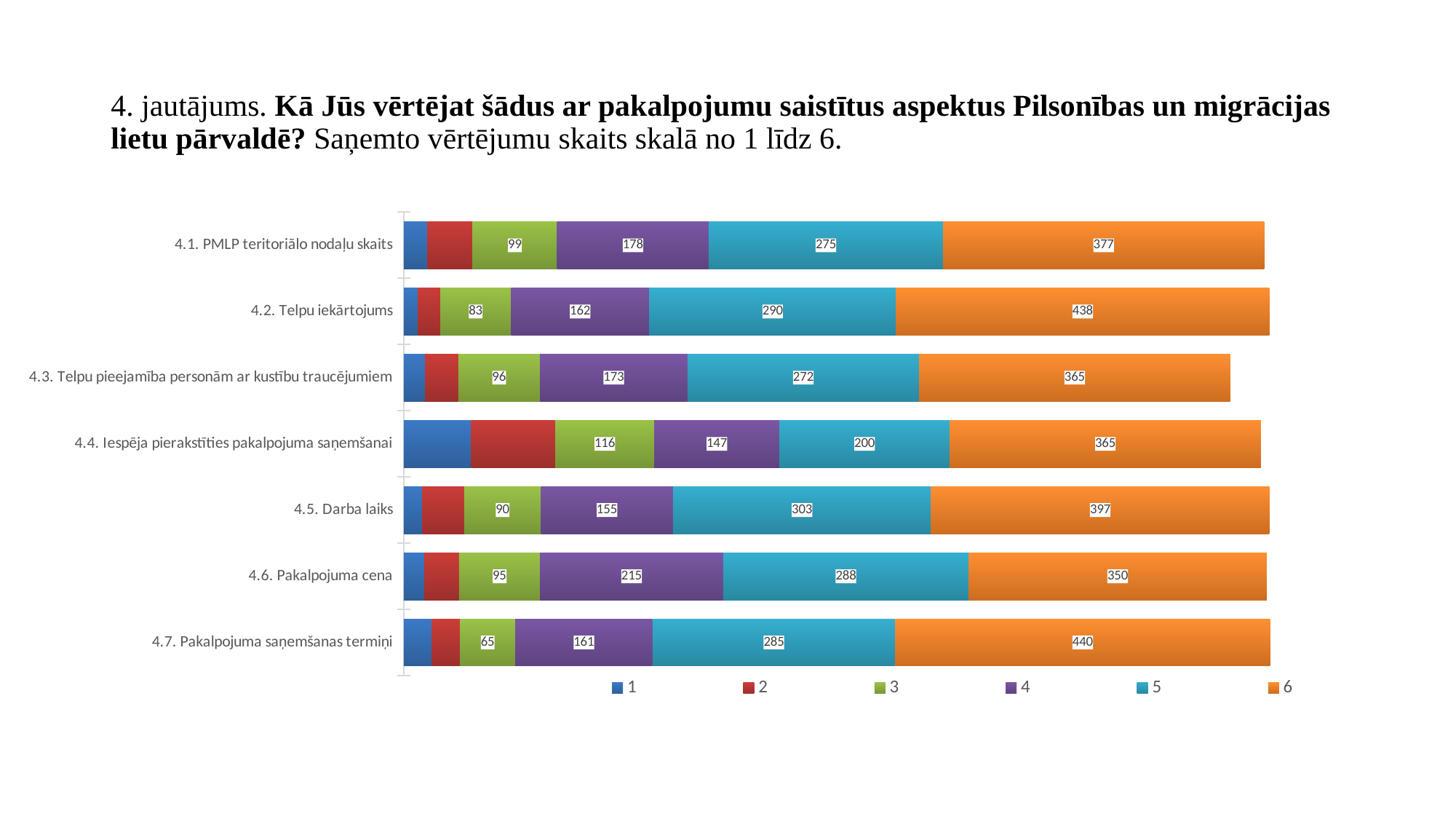
What is the value of series 6 for "4.7. Pakalpojuma saņemšanas termiņi"? 440 How many series does the legend list? 6 Which is larger: the series 5 value for "4.2. Telpu iekārtojums" or for "4.4. Iespēja pierakstīties pakalpojuma saņemšanai"? 4.2. Telpu iekārtojums Which series is shown in orange in the legend? 6 Which category has the highest value for series 6? 4.7. Pakalpojuma saņemšanas termiņi What is the difference between the series 6 values for "4.2. Telpu iekārtojums" and "4.1. PMLP teritoriālo nodaļu skaits"? 61 What kind of chart is shown on the slide? Stacked bar chart What is the value of series 5 for "4.5. Darba laiks"? 303 What is the value of series 3 for "4.4. Iespēja pierakstīties pakalpojuma saņemšanai"? 116 How many categories (aspects) are plotted on the chart? 7 What is the value of series 4 for "4.6. Pakalpojuma cena"? 215 Which category has the lowest value for series 3? 4.7. Pakalpojuma saņemšanas termiņi